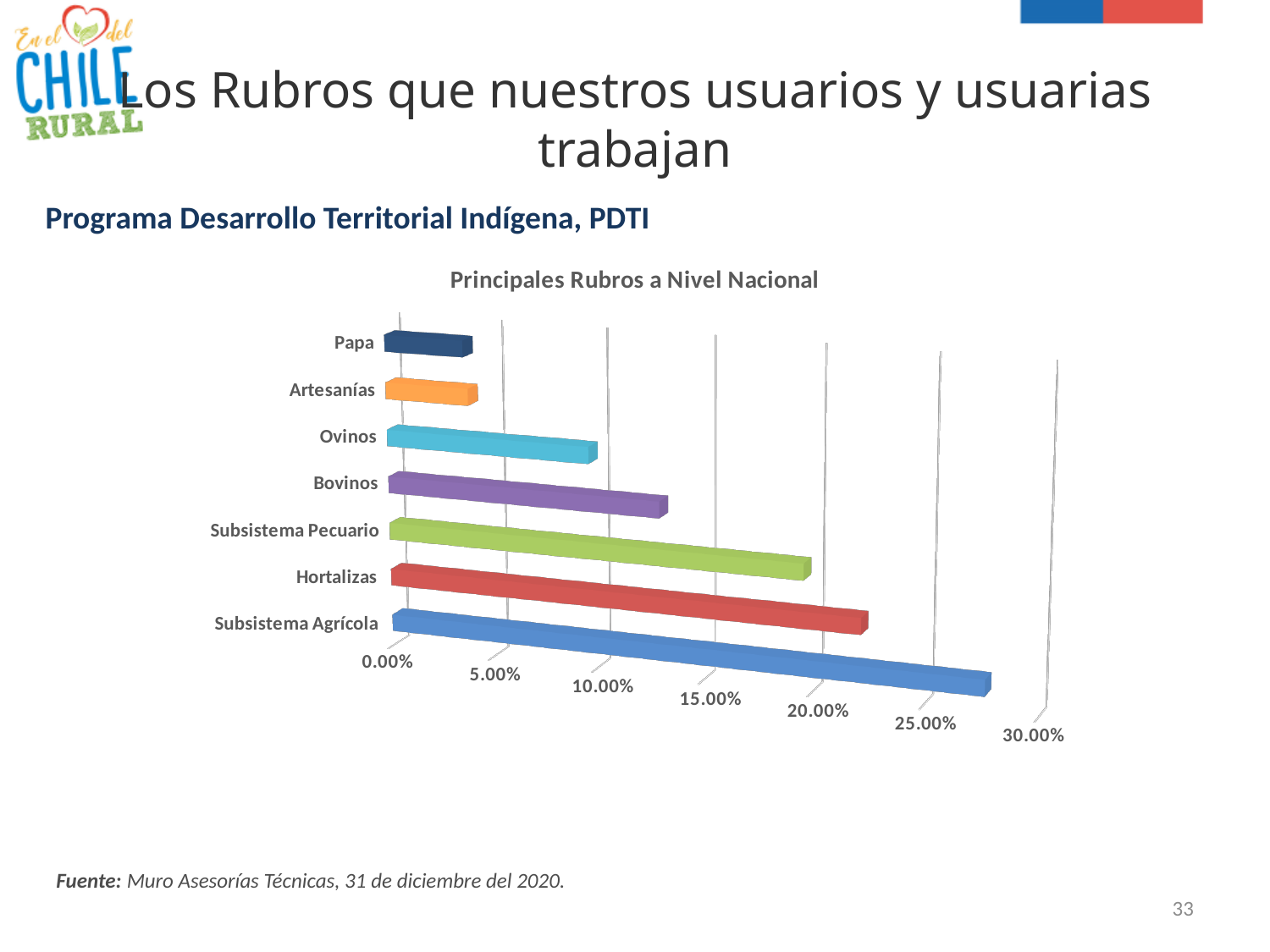
How many categories (rubros) are plotted in the chart? 7 What is the title of the chart? Principales Rubros a Nivel Nacional What colour is the bar for Hortalizas? red Which has a larger value, Hortalizas or Bovinos? Hortalizas Which category has the highest value in the chart? Subsistema Agrícola What kind of chart is shown on the slide? bar chart Which has a larger value, Ovinos or Subsistema Pecuario? Subsistema Pecuario Is the value for Hortalizas greater or less than 20.00%? greater Is the value for Bovinos greater or less than 10.00%? greater Is the value for Subsistema Agrícola greater or less than 25.00%? greater